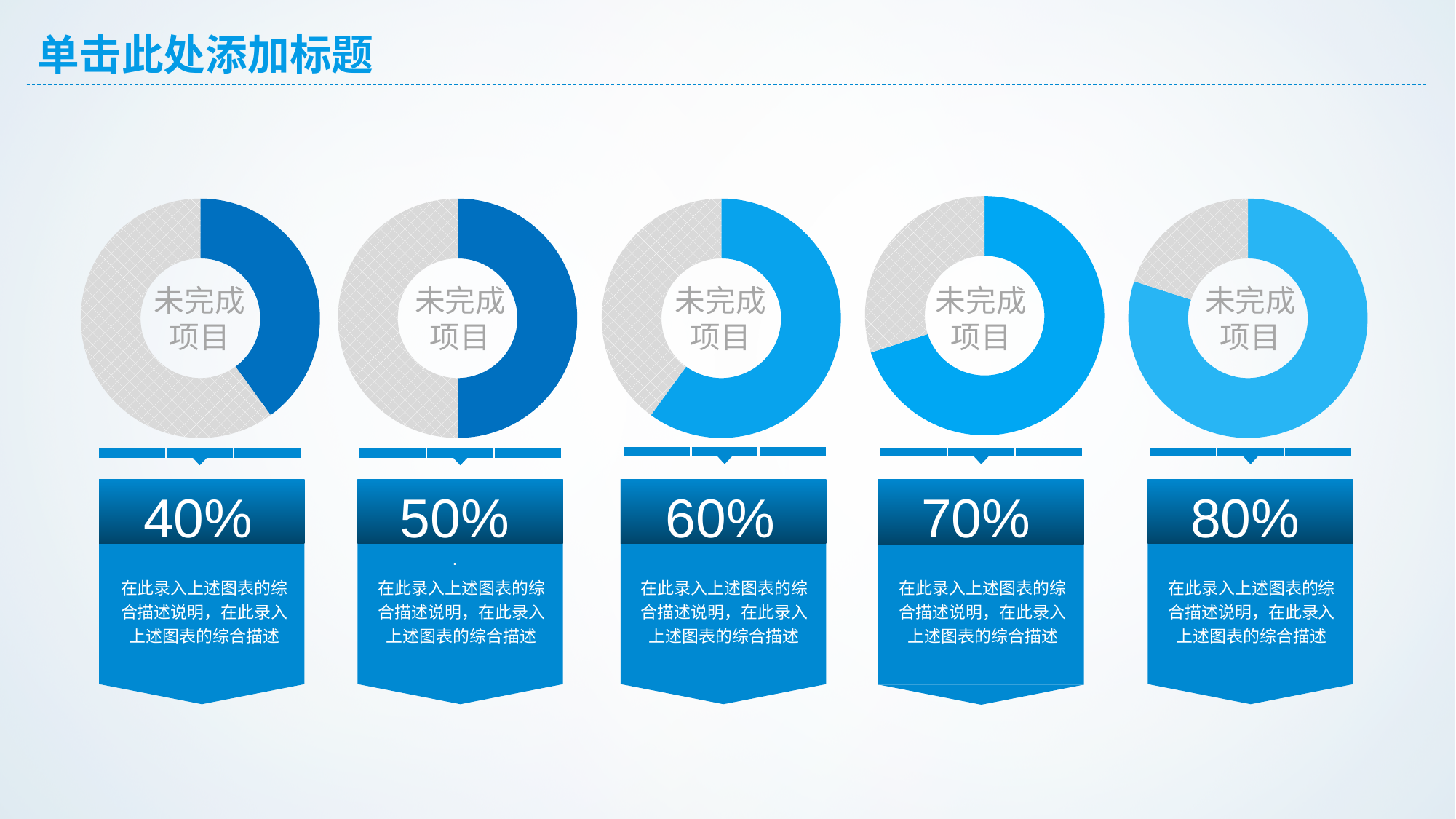
Which donut chart shows the lowest percentage? The leftmost (40%) What percentage is shown below the middle (third) donut chart? 60% Which is larger: the percentage of the second donut chart or the fourth donut chart? The fourth (70%) What kind of chart is used on this slide? Donut chart What percentage is shown below the leftmost donut chart? 40% What percentage is shown below the fourth donut chart from the left? 70% Which donut chart shows the highest percentage? The rightmost (80%) What percentage is shown below the rightmost donut chart? 80% What text appears in the center of each donut chart? 未完成项目 How many donut charts are on the slide? 5 Do the percentages rise or fall from left to right across the donut charts? Rise What is the difference between the percentage of the rightmost donut chart and the leftmost donut chart? 40%